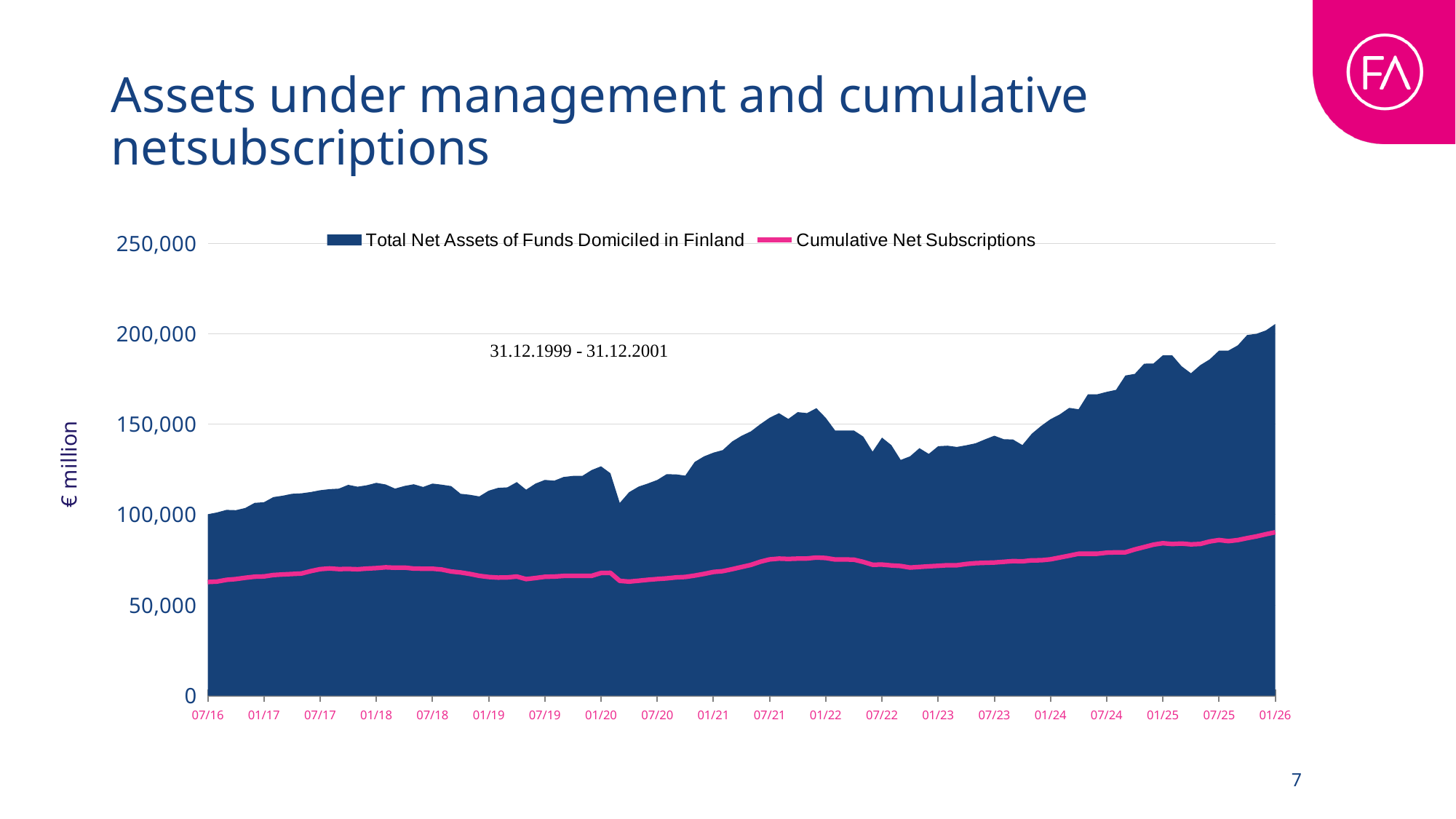
Is the value of Total Net Assets of Funds Domiciled in Finland at 01/26 greater or less than 200,000? greater Is the value of Total Net Assets of Funds Domiciled in Finland at 07/24 greater or less than 150,000? greater How many date labels are shown along the x axis? 20 At 01/26, which is larger: Total Net Assets of Funds Domiciled in Finland or Cumulative Net Subscriptions? Total Net Assets of Funds Domiciled in Finland Is the value of Cumulative Net Subscriptions at 07/16 greater or less than 50,000? greater What is the label on the vertical axis? € million Overall, do the Total Net Assets of Funds Domiciled in Finland rise or fall from 07/16 to 01/26? rise How many series does the legend list? 2 What kind of chart is shown on the slide? Area chart with a line series What are the two series named in the legend? Total Net Assets of Funds Domiciled in Finland; Cumulative Net Subscriptions